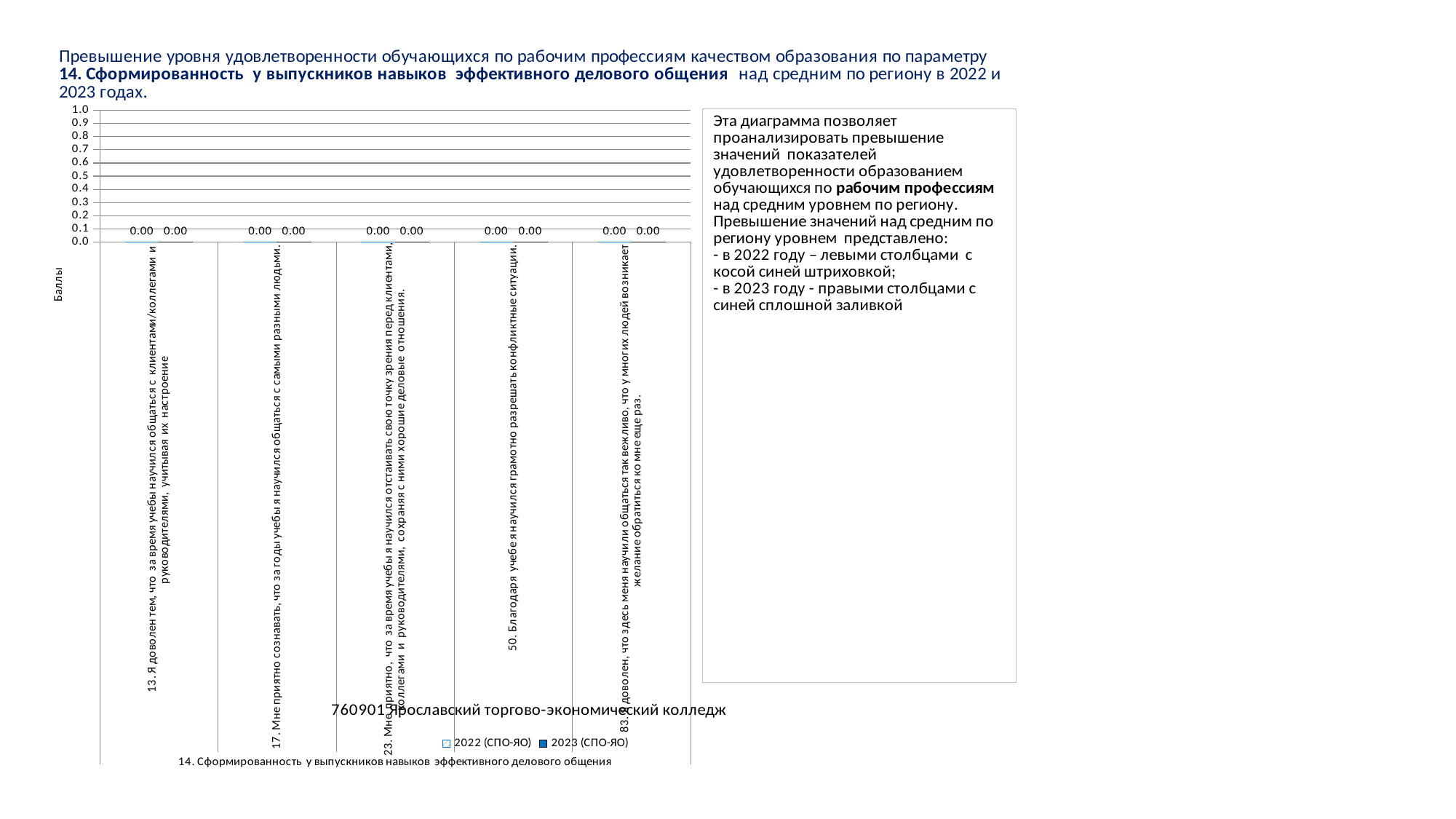
What is the difference between the 2022 (СПО-ЯО) and 2023 (СПО-ЯО) values for category 23? 0.00 Is the value for the 2023 (СПО-ЯО) series for category 13 greater or less than 0.5? less What is the value for the 2022 (СПО-ЯО) series for category 13 ("Я доволен тем, что за время учебы научился общаться с клиентами/коллегами и руководителями, учитывая их настроение")? 0.00 How many categories are shown on the x axis of the chart? 5 What is the value for the 2022 (СПО-ЯО) series for category 83 ("Я доволен, что здесь меня научили общаться так вежливо...")? 0.00 What kind of chart is shown on the slide? bar chart What is the highest value shown on the vertical axis of the chart? 1.0 What is the value for the 2023 (СПО-ЯО) series for category 50 ("Благодаря учебе я научился грамотно разрешать конфликтные ситуации")? 0.00 What is the label of the vertical axis of the chart? Баллы How many series does the chart legend list? 2 What are the two series named in the chart legend? 2022 (СПО-ЯО) and 2023 (СПО-ЯО) What is the value for the 2023 (СПО-ЯО) series for category 17 ("Мне приятно сознавать, что за годы учебы я научился общаться с самыми разными людьми")? 0.00